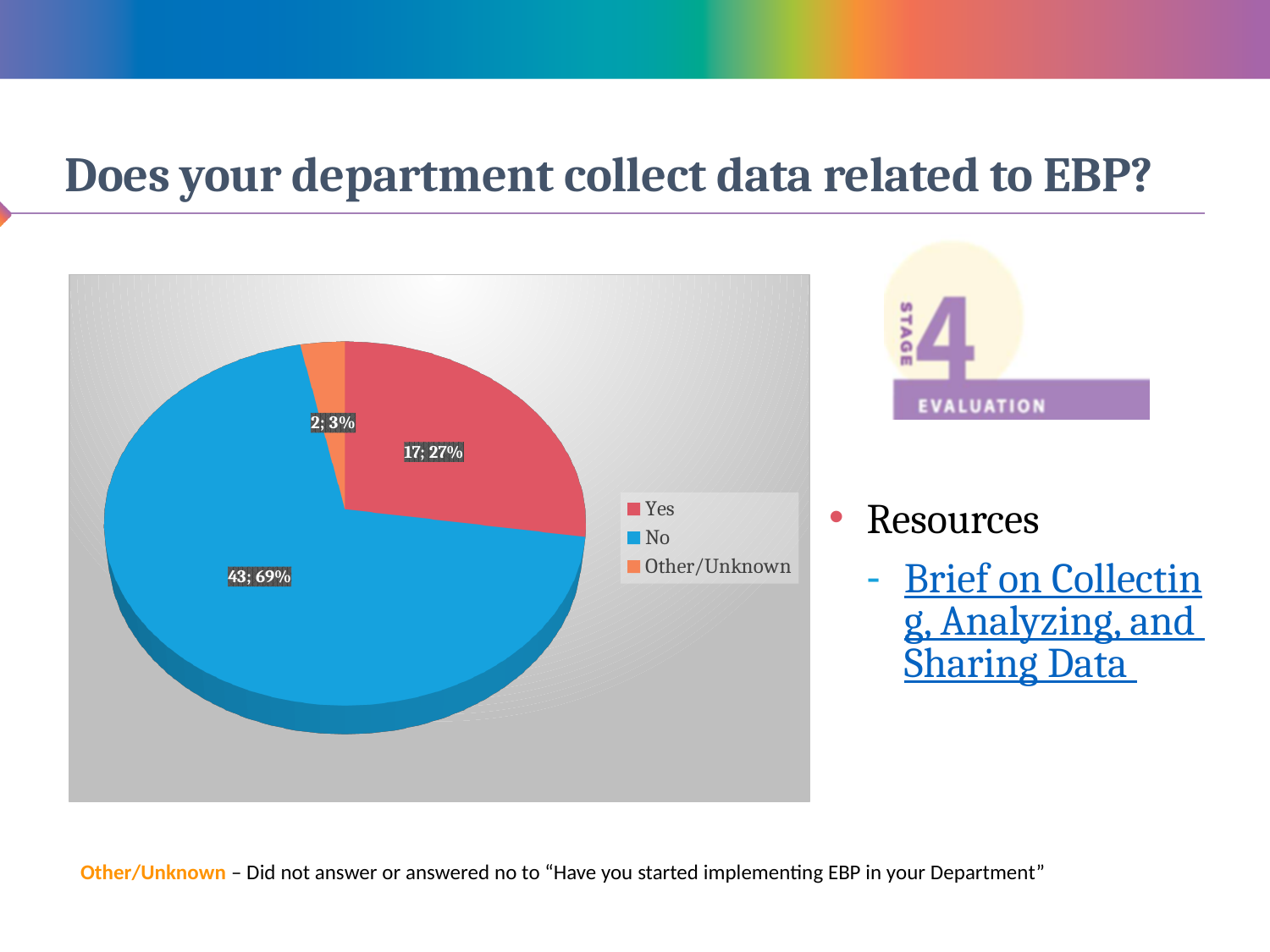
How many categories does the legend list? 3 What is the count for the Other/Unknown slice? 2 How many departments answered "Yes" to collecting data related to EBP? 17 Which category has the smallest slice? Other/Unknown What percentage of the pie does the "No" slice represent? 69% How many departments answered "No"? 43 What colour is the "No" slice? blue Which category has the largest slice? No What share of the pie is the Other/Unknown slice? 3% What is the difference between the number of "No" and "Yes" responses? 26 What kind of chart is shown on the slide? pie chart What share of the pie is the "Yes" slice? 27%